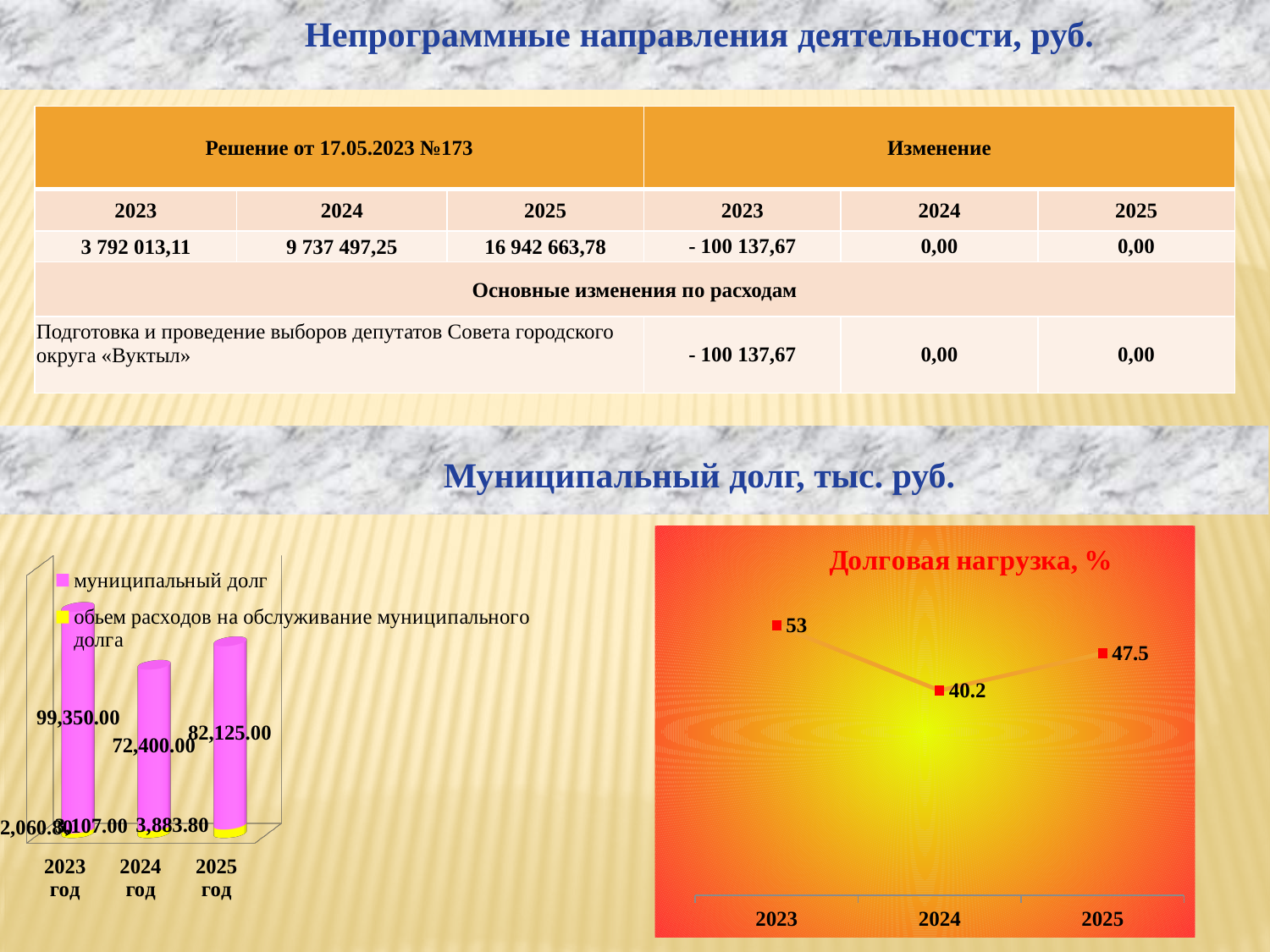
How many series does the legend of the left chart (municipal debt) list? 2 In the left chart (municipal debt), which year has the lowest value of 'муниципальный долг'? 2024 год In the left chart (municipal debt), what is the value of 'муниципальный долг' for 2025 год? 82,125.00 In the left chart (municipal debt), what is the difference between 'муниципальный долг' in 2023 год and 2024 год? 26,950.00 In the chart 'Долговая нагрузка, %', what is the value for 2024? 40.2 In the left chart (municipal debt), what is the value of 'муниципальный долг' for 2023 год? 99,350.00 What kind of chart is the left chart (municipal debt)? bar chart In the left chart (municipal debt), what is the value of 'муниципальный долг' for 2024 год? 72,400.00 In the left chart (municipal debt), what is the value of 'объем расходов на обслуживание муниципального долга' for 2025 год? 3,883.80 In the chart 'Долговая нагрузка, %', which year has the highest value? 2023 In the left chart (municipal debt), which year has the highest value of 'муниципальный долг'? 2023 год In the chart 'Долговая нагрузка, %', what is the difference between the values for 2023 and 2025? 5.5